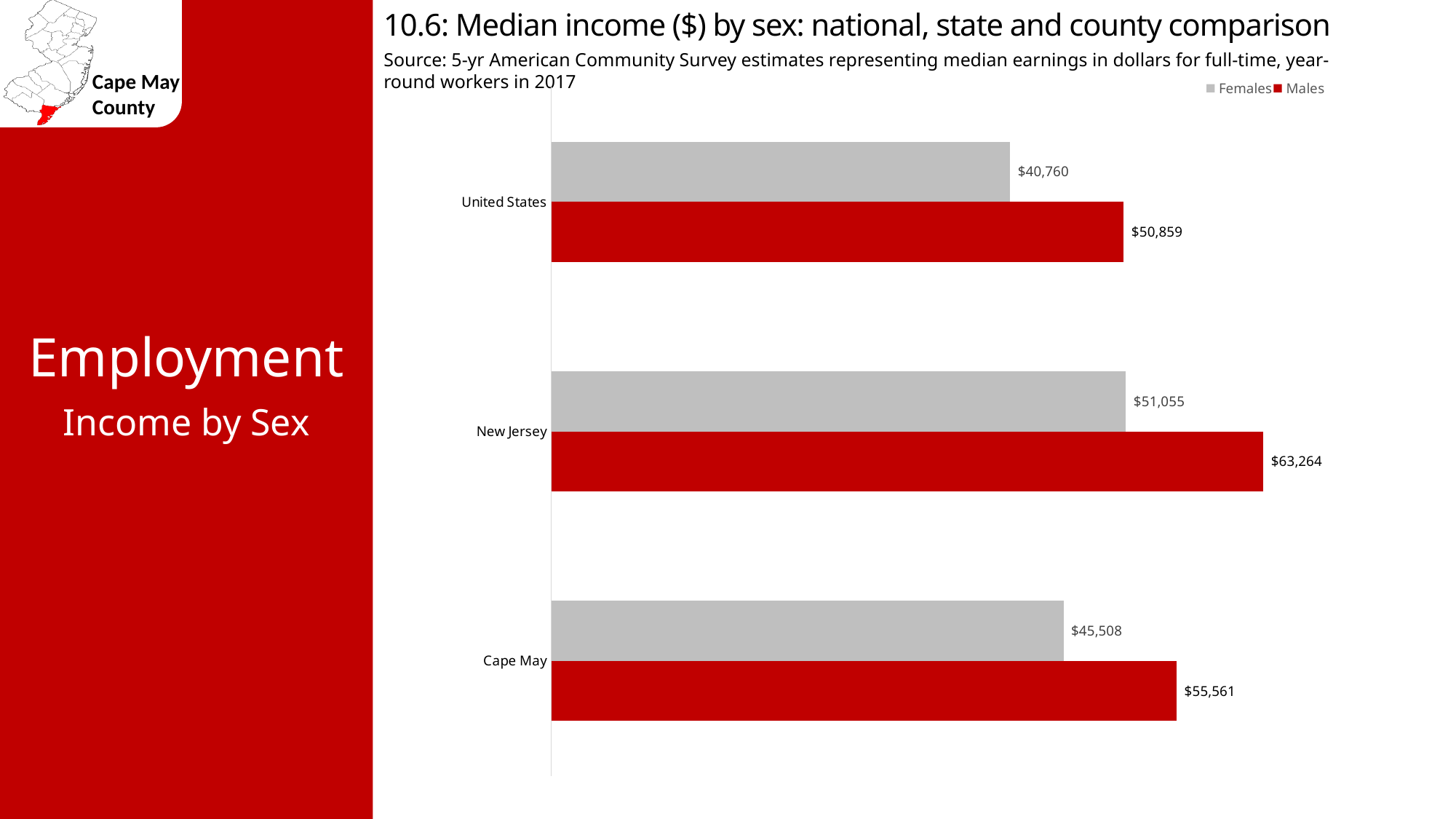
What is the difference between male and female median income in Cape May? $10,053 How many series does the legend list? 2 What kind of chart is shown on the slide? Bar chart What is the median income for females in the United States? $40,760 What is the median income for males in Cape May? $55,561 What is the median income for females in Cape May? $45,508 Which is larger: the female median income in New Jersey or the male median income in the United States? Female median income in New Jersey What is the median income for males in New Jersey? $63,264 Which geography has the lowest median income for females? United States What is the difference between male and female median income in New Jersey? $12,209 Which geography has the highest median income for males? New Jersey How many geographies are shown on the chart? 3